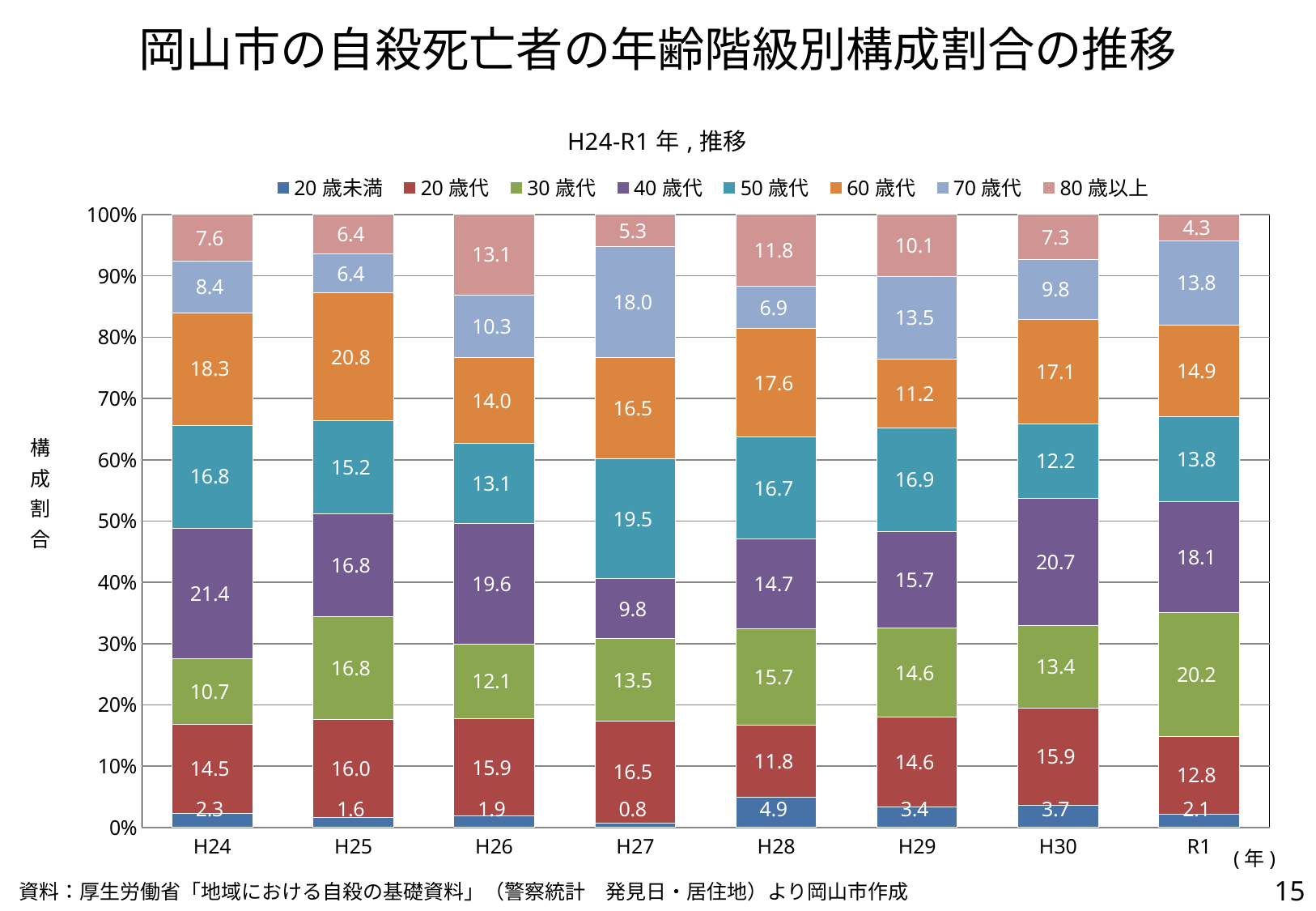
How many series does the legend list? 8 What kind of chart is shown on the slide? Stacked bar chart What is the difference between the 40歳代 value in H30 and in H27? 10.9 In H27, which age group has the largest share? 50歳代 What is the difference between the 60歳代 value in H25 and in H24? 2.5 What is the value for 80歳以上 in R1? 4.3 What is the value for 70歳代 in H27? 18.0 What is the value for 40歳代 in H24? 21.4 Which is larger, the 30歳代 value in R1 or in H24? R1 In which year is the 20歳未満 share the highest? H28 How many years are shown on the x axis? 8 In which year is the 20歳未満 share the lowest? H27